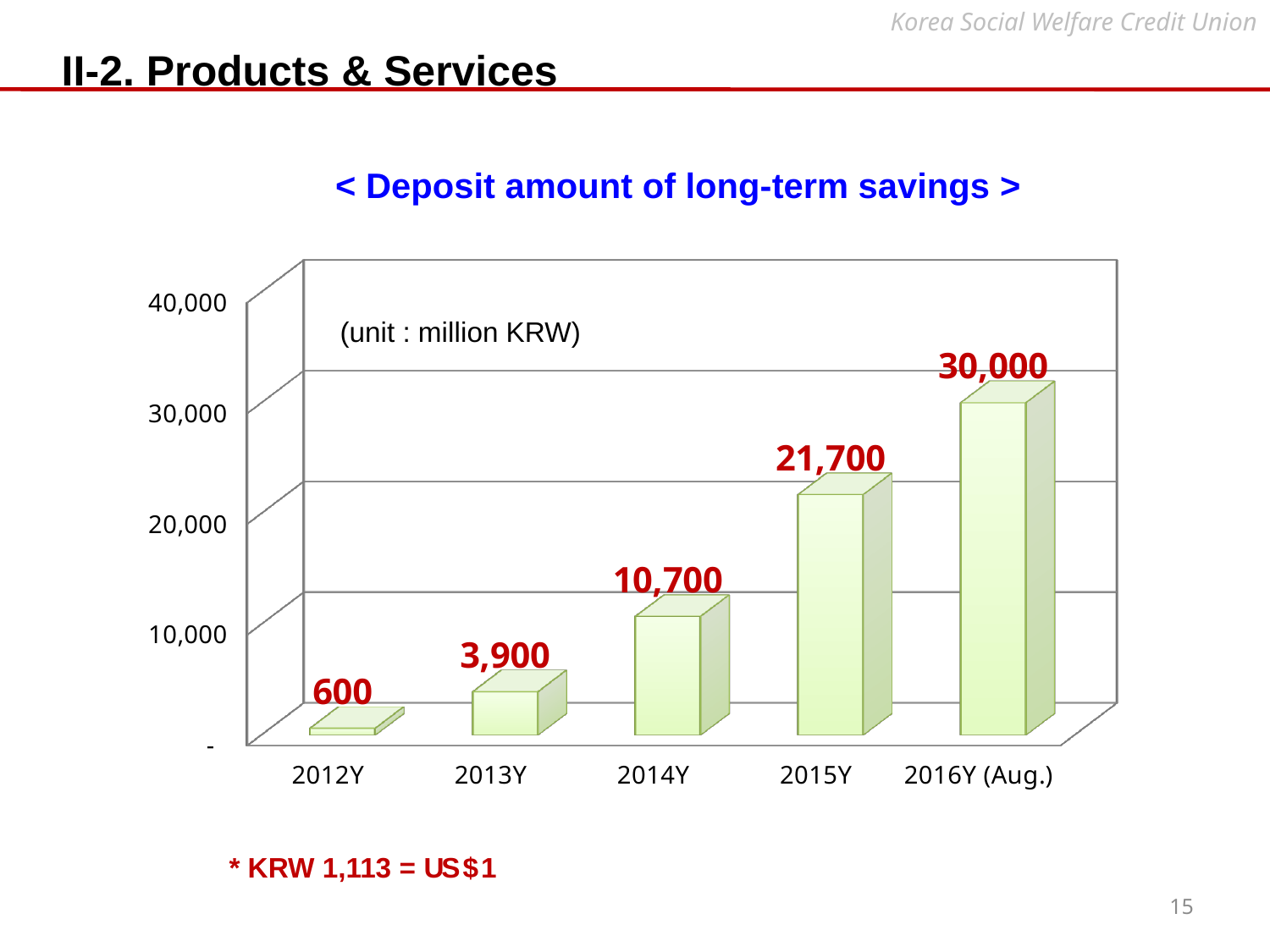
What is the difference in deposit amount between 2013Y and 2012Y? 3,300 What is the difference in deposit amount between 2015Y and 2014Y? 11,000 What is the deposit amount of long-term savings for 2016Y (Aug.)? 30,000 Is the deposit amount for 2015Y greater or less than 20,000? greater Do the deposit amounts rise or fall from 2012Y to 2016Y (Aug.)? rise Which year has the lowest deposit amount of long-term savings? 2012Y How many years are shown on the x axis of the chart? 5 What kind of chart is used to show the deposit amount of long-term savings? bar chart Which is larger, the deposit amount for 2013Y or for 2015Y? 2015Y Which year has the highest deposit amount of long-term savings? 2016Y (Aug.) What is the deposit amount of long-term savings for 2014Y? 10,700 What is the deposit amount of long-term savings for 2012Y? 600